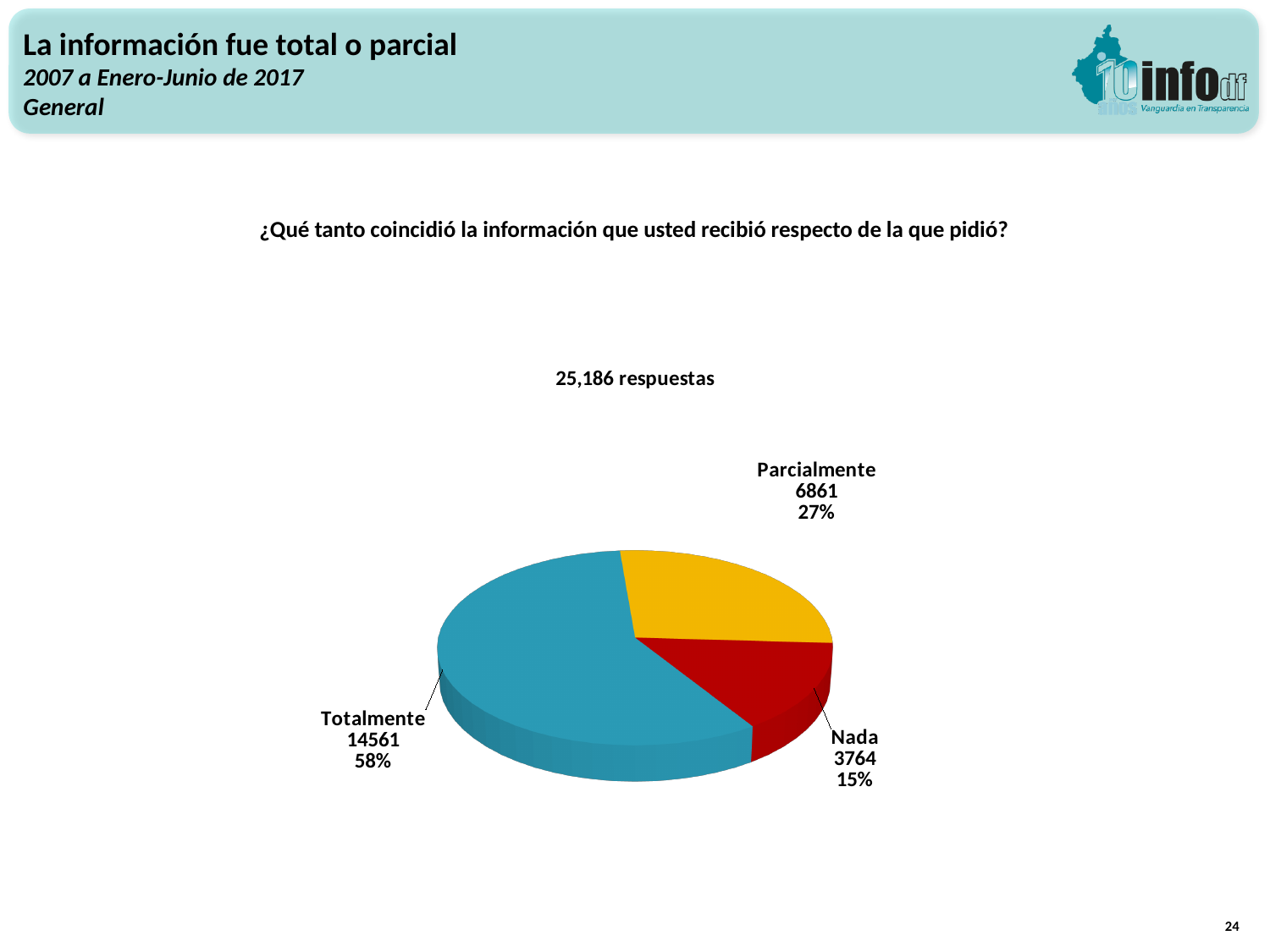
Which category has the largest slice? Totalmente How many slices does the pie chart have? 3 What is the value for Totalmente? 14561 What is the difference between the values for Totalmente and Parcialmente? 7700 What type of chart is shown on the slide? pie chart What share of the pie does Nada represent? 15% How many total responses (respuestas) does the chart report? 25,186 respuestas Which category has the smallest slice? Nada What is the value for Nada? 3764 What is the value for Parcialmente? 6861 What share of the pie does Totalmente represent? 58% Which is larger, the value for Parcialmente or the value for Nada? Parcialmente